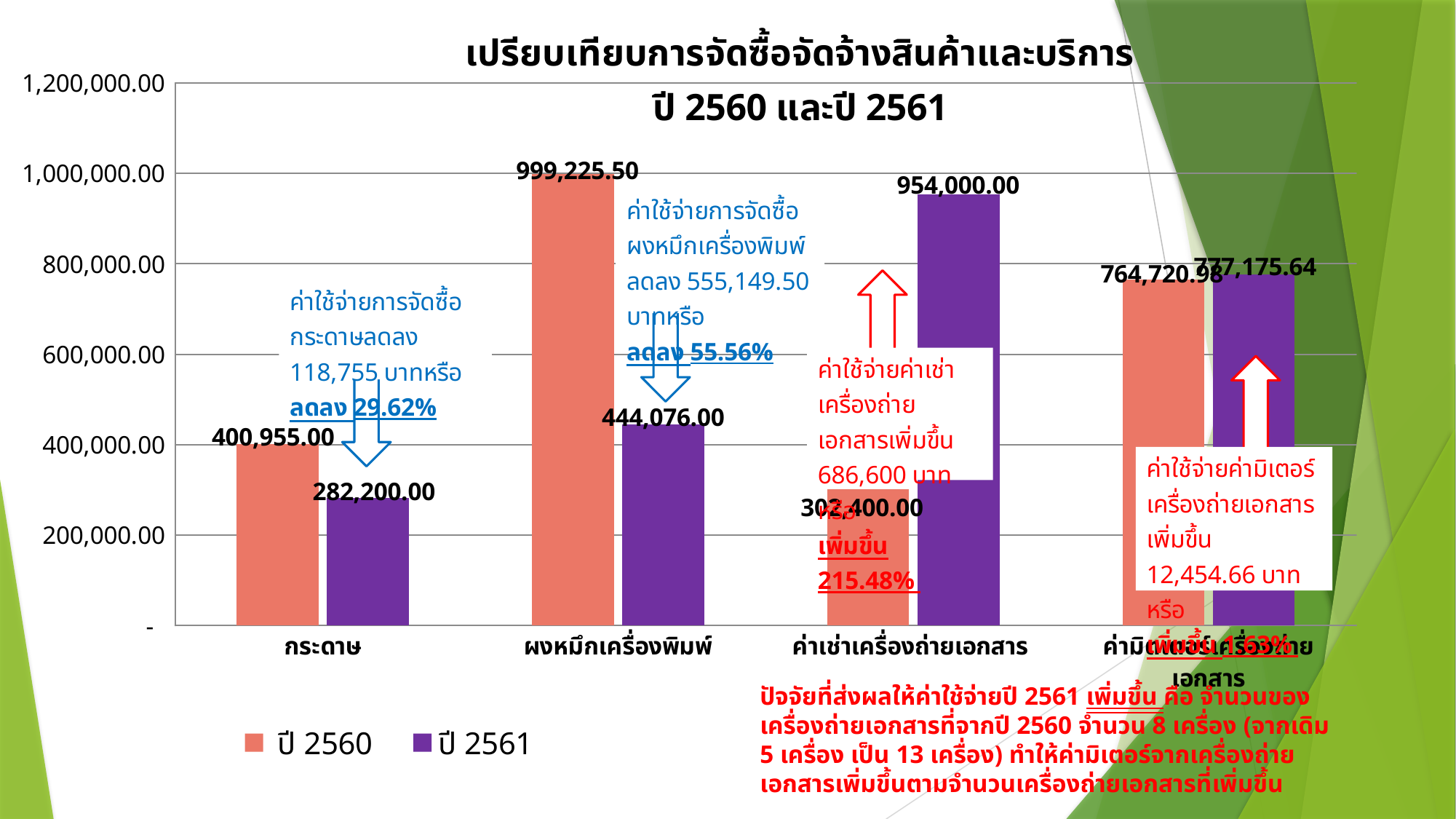
For ค่าเช่าเครื่องถ่ายเอกสาร, which series has the larger value, ปี 2560 or ปี 2561? ปี 2561 What kind of chart is shown on the slide? bar chart Which category has the highest value in the ปี 2561 series? ค่าเช่าเครื่องถ่ายเอกสาร Is the ปี 2561 value for ค่ามิเตอร์เครื่องถ่ายเอกสาร greater or less than 600,000.00? greater How many series does the chart legend list? 2 Which category has the lowest value in the ปี 2561 series? กระดาษ What is the value for ผงหมึกเครื่องพิมพ์ in the ปี 2560 series? 999,225.50 What is the value for ผงหมึกเครื่องพิมพ์ in the ปี 2561 series? 444,076.00 What is the difference between the ปี 2560 and ปี 2561 values for ผงหมึกเครื่องพิมพ์? 555,149.50 How many categories are shown on the x axis of the chart? 4 What is the value for ค่าเช่าเครื่องถ่ายเอกสาร in the ปี 2561 series? 954,000.00 What is the value for กระดาษ in the ปี 2560 series? 400,955.00